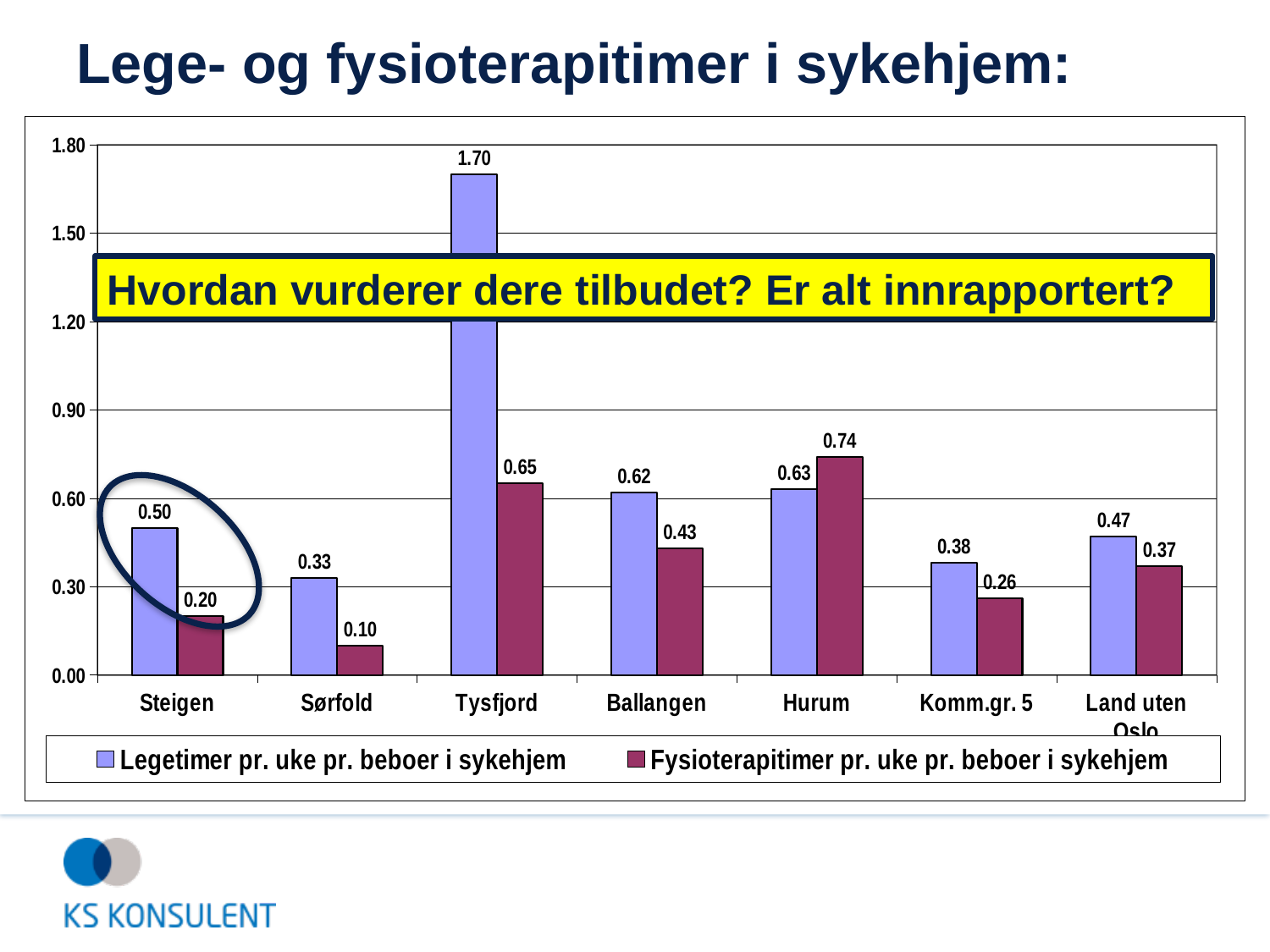
What kind of chart is shown on the slide? Bar chart How many series does the legend list? 2 What is the difference between Legetimer and Fysioterapitimer pr. uke pr. beboer i sykehjem for Steigen? 0.30 What is the title of the slide? Lege- og fysioterapitimer i sykehjem: Is the value of Legetimer pr. uke pr. beboer i sykehjem for Ballangen greater or less than 0.60? greater What is the value of Fysioterapitimer pr. uke pr. beboer i sykehjem for Sørfold? 0.10 What is the value of Fysioterapitimer pr. uke pr. beboer i sykehjem for Hurum? 0.74 Which category has the lowest value for Fysioterapitimer pr. uke pr. beboer i sykehjem? Sørfold Which is larger for Hurum: Legetimer or Fysioterapitimer pr. uke pr. beboer i sykehjem? Fysioterapitimer pr. uke pr. beboer i sykehjem What is the value of Legetimer pr. uke pr. beboer i sykehjem for Tysfjord? 1.70 How many categories are shown on the x axis? 7 Which category has the highest value for Legetimer pr. uke pr. beboer i sykehjem? Tysfjord